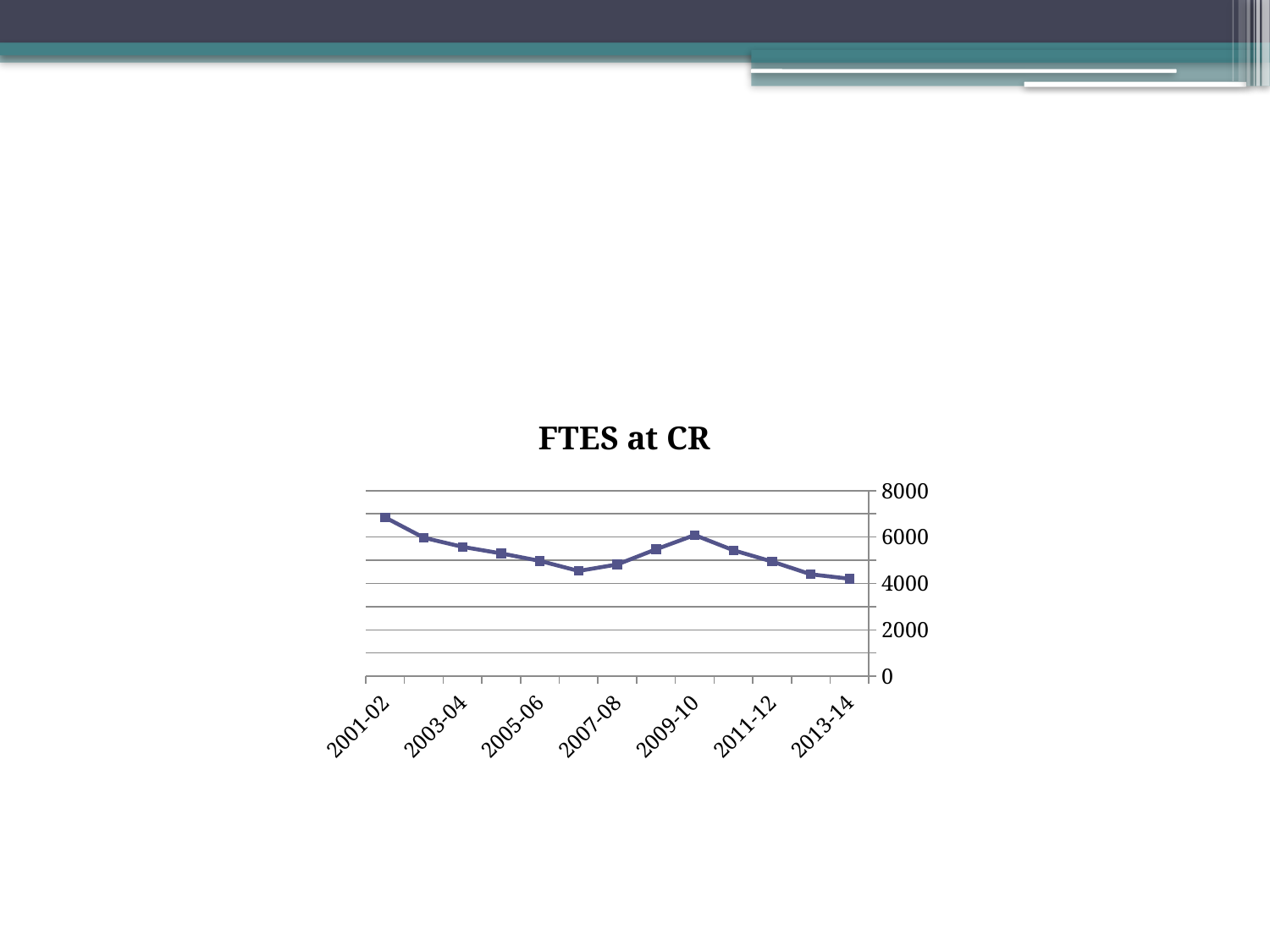
How many data points are plotted on the line? 13 Which year has the lowest FTES value? 2013-14 Is the value for 2007-08 greater or less than 6000? less Is the value for 2009-10 greater or less than 4000? greater Which is larger, the value for 2001-02 or the value for 2013-14? 2001-02 Is the value for 2013-14 greater or less than 6000? less Which is larger, the value for 2009-10 or the value for 2007-08? 2009-10 What is the title of the chart? FTES at CR What kind of chart is shown on the slide? line chart Which year has the highest FTES value? 2001-02 Overall, do the values rise or fall from 2001-02 to 2013-14? fall